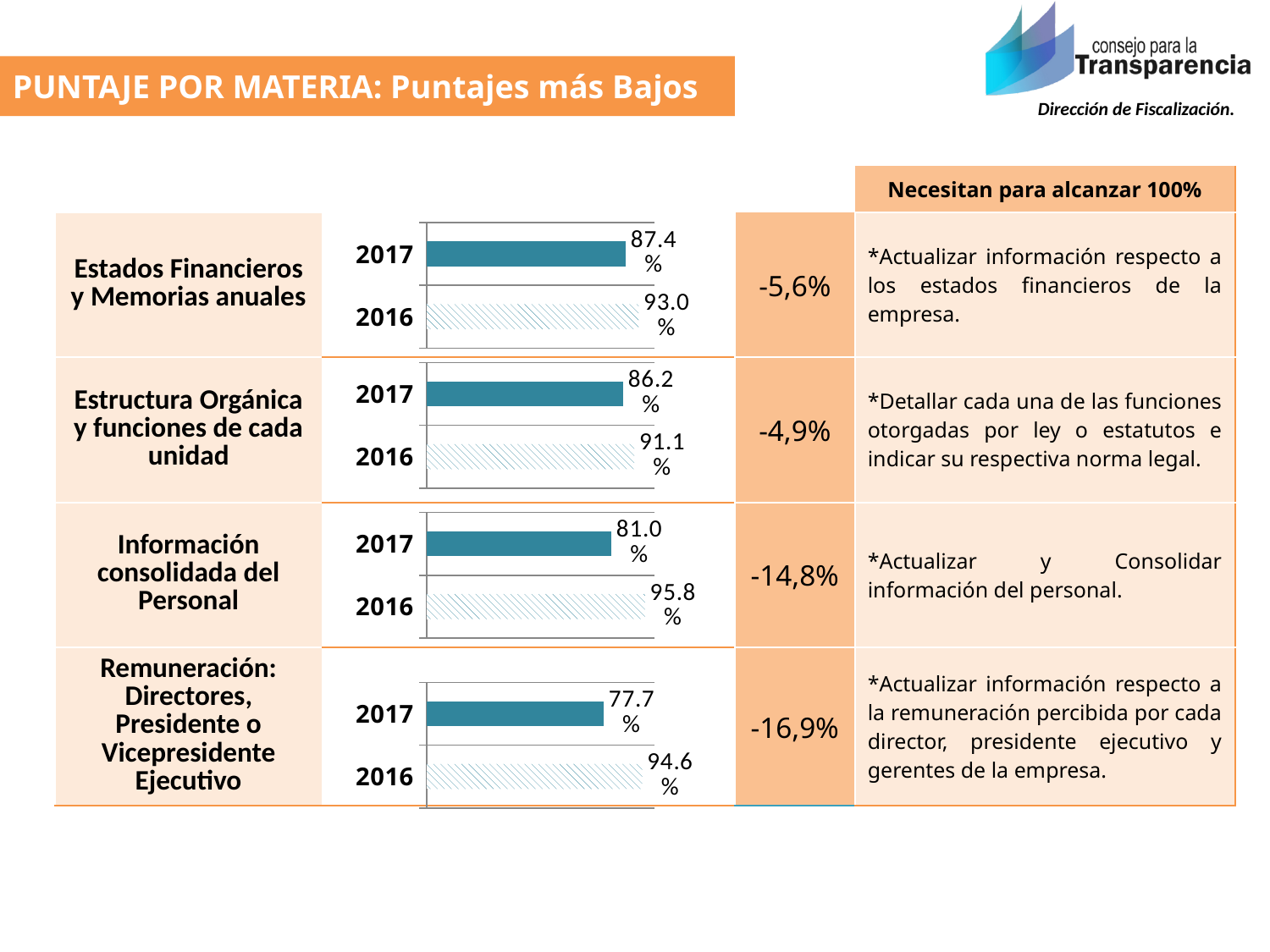
In the chart for Remuneración: Directores, Presidente o Vicepresidente Ejecutivo, which year has the lower value? 2017 What type of chart is used in the Estados Financieros y Memorias anuales row? bar chart In the chart for Estados Financieros y Memorias anuales, what is the difference between the 2016 and 2017 values? 5.6% In the chart for Remuneración: Directores, Presidente o Vicepresidente Ejecutivo, what is the value for 2016? 94.6% In the chart for Estados Financieros y Memorias anuales, what is the value for 2016? 93.0% In the chart for Información consolidada del Personal, what is the difference between the 2016 and 2017 values? 14.8% In the chart for Estructura Orgánica y funciones de cada unidad, what is the value for 2016? 91.1% In the chart for Información consolidada del Personal, which year has the higher value? 2016 How many bars are shown in the chart for Estructura Orgánica y funciones de cada unidad? 2 In the chart for Estructura Orgánica y funciones de cada unidad, is the value for 2017 larger or smaller than the value for 2016? smaller In the chart for Estados Financieros y Memorias anuales, what is the value for 2017? 87.4% In the chart for Información consolidada del Personal, what is the value for 2017? 81.0%